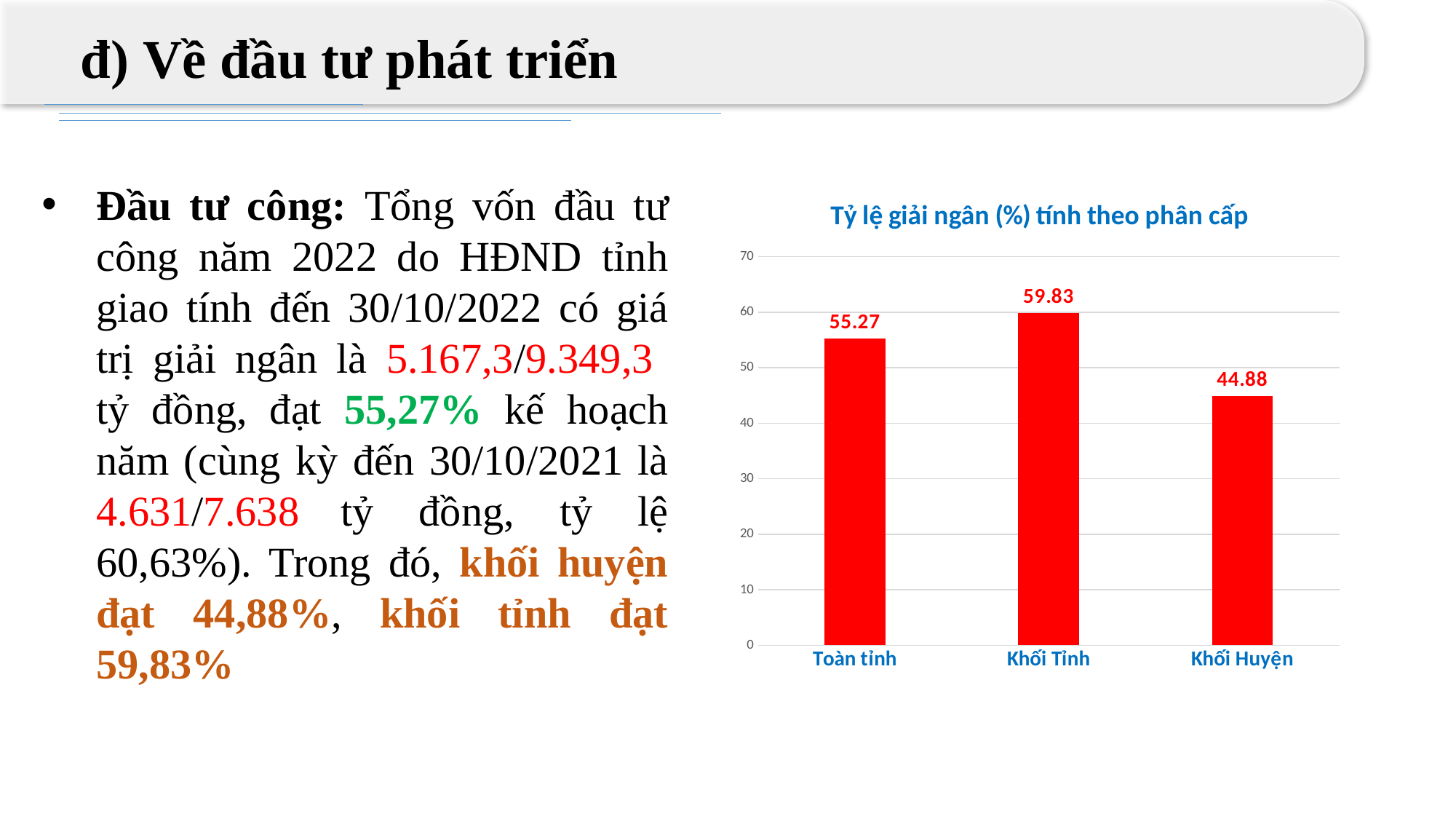
Which category has the lowest value in the chart? Khối Huyện What kind of chart is shown on the slide? bar chart What is the value for Toàn tỉnh in the chart? 55.27 What is the difference between the values for Khối Tỉnh and Khối Huyện? 14.95 How many categories are shown in the chart? 3 Is the value for Khối Huyện greater or less than 50? less Which is larger, the value for Toàn tỉnh or the value for Khối Huyện? Toàn tỉnh What is the title of the chart? Tỷ lệ giải ngân (%) tính theo phân cấp What is the value for Khối Huyện in the chart? 44.88 What is the difference between the values for Khối Tỉnh and Toàn tỉnh? 4.56 What is the value for Khối Tỉnh in the chart? 59.83 Which category has the highest value in the chart? Khối Tỉnh